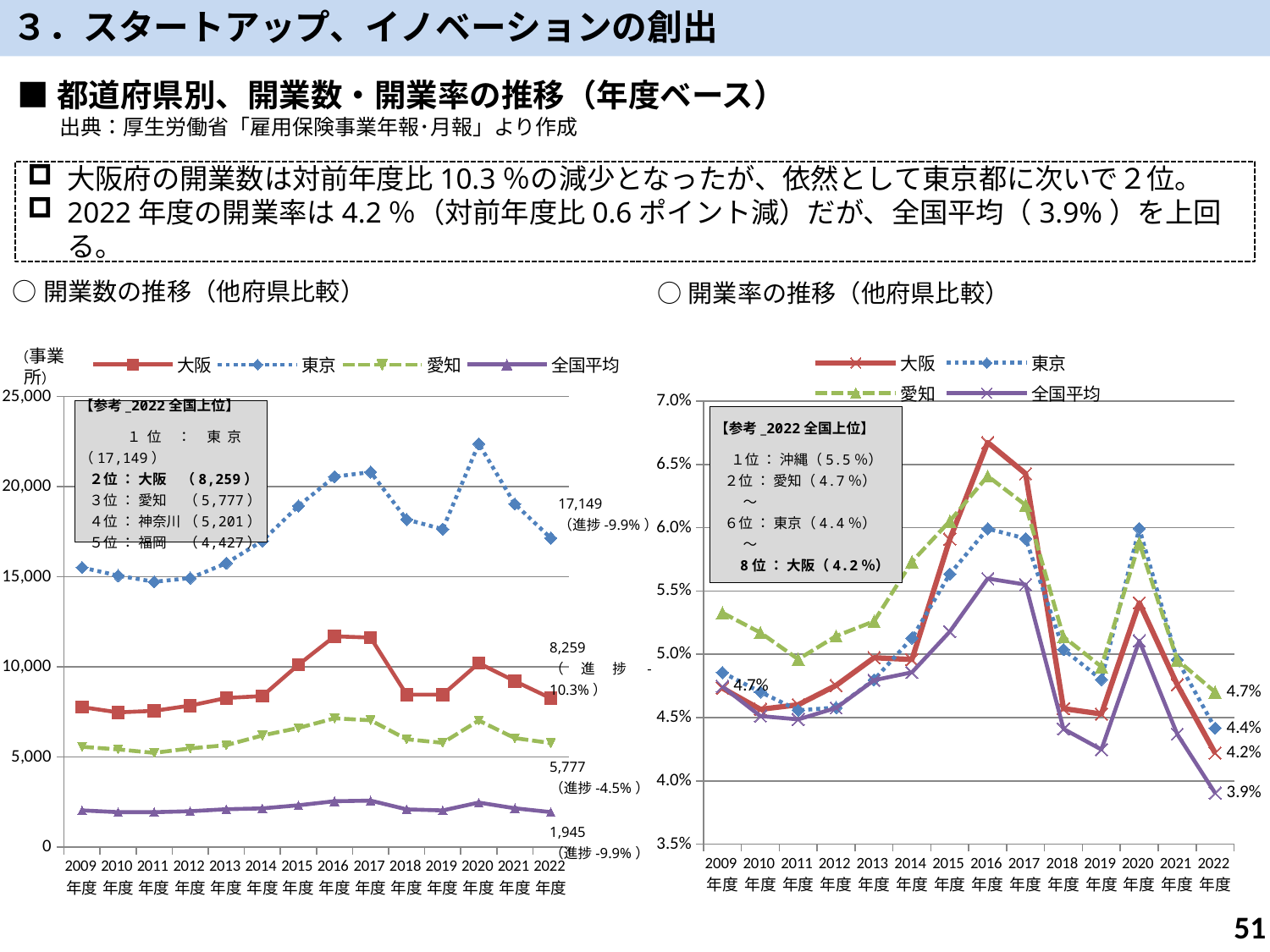
In the left chart (開業数の推移), which series has the lowest value in 2022年度? 全国平均 In the right chart (開業率の推移), is the value for 大阪 in 2016年度 greater or less than 6.0%? greater In the right chart (開業率の推移), what is the value for 愛知 in 2022年度? 4.7% In the right chart (開業率の推移), what is the value for 全国平均 in 2022年度? 3.9% How many years are shown on the x axis of the left chart (開業数の推移)? 14 In the left chart (開業数の推移), what is the value for 大阪 in 2022年度? 8,259 What type of chart is the left chart (開業数の推移)? line chart In the left chart (開業数の推移), is the value for 東京 in 2020年度 greater or less than 20,000? greater How many series does the legend of the right chart (開業率の推移) list? 4 In the right chart (開業率の推移), which is larger in 2022年度, 大阪 or 全国平均? 大阪 In the left chart (開業数の推移), what is the difference between 東京 and 大阪 in 2022年度? 8,890 In the left chart (開業数の推移), what is the value for 東京 in 2022年度? 17,149